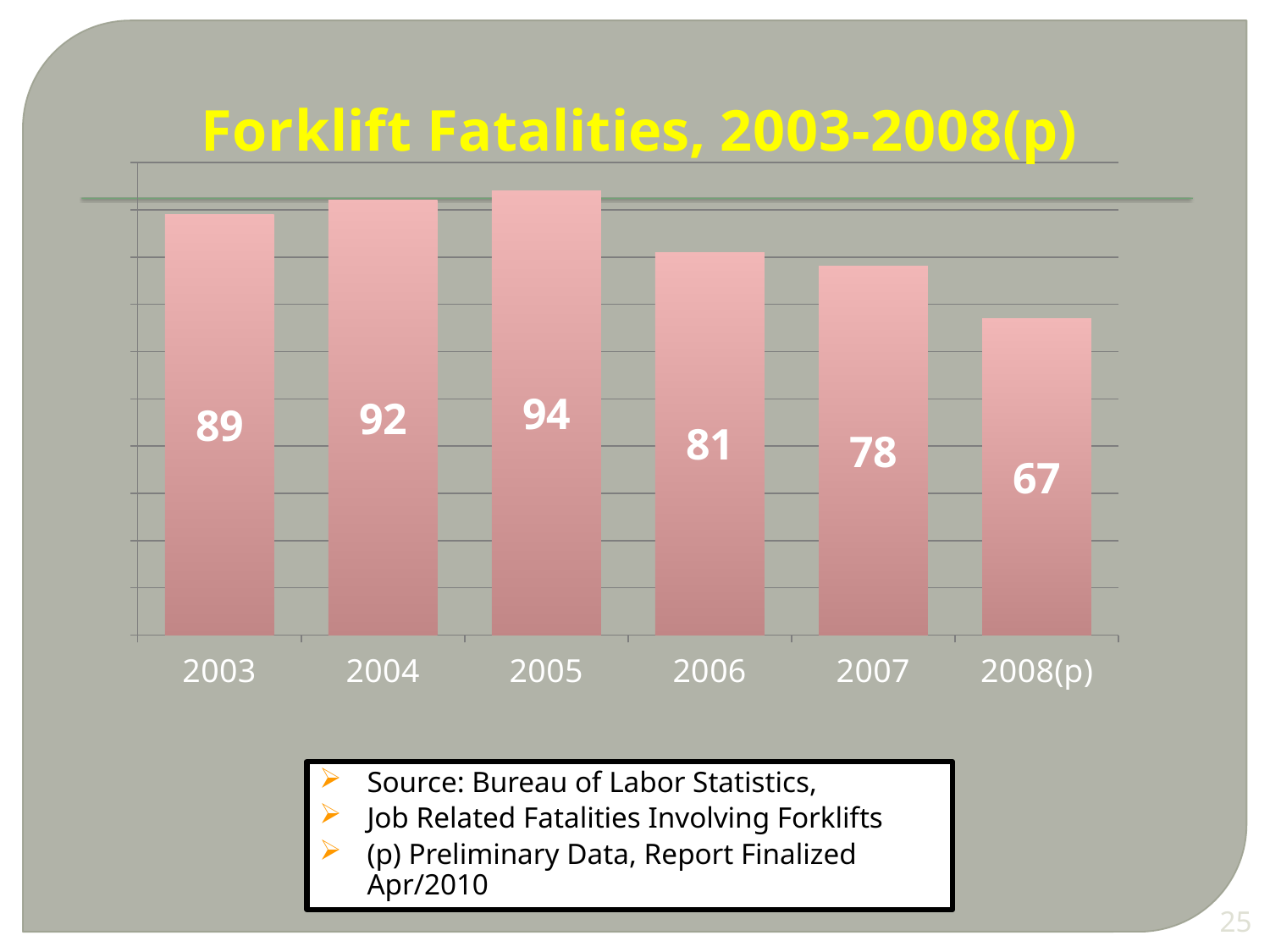
Do the values rise or fall from 2005 to 2008(p)? fall Which year has the highest value? 2005 Which year has the lowest value? 2008(p) What is the value for 2003? 89 What is the title of the chart? Forklift Fatalities, 2003-2008(p) What is the difference between the values for 2004 and 2007? 14 What is the value for 2006? 81 Which is larger, the value for 2006 or the value for 2007? 2006 What is the difference between the values for 2005 and 2008(p)? 27 What kind of chart is this? bar chart What is the value for 2008(p)? 67 How many years are shown on the x axis? 6